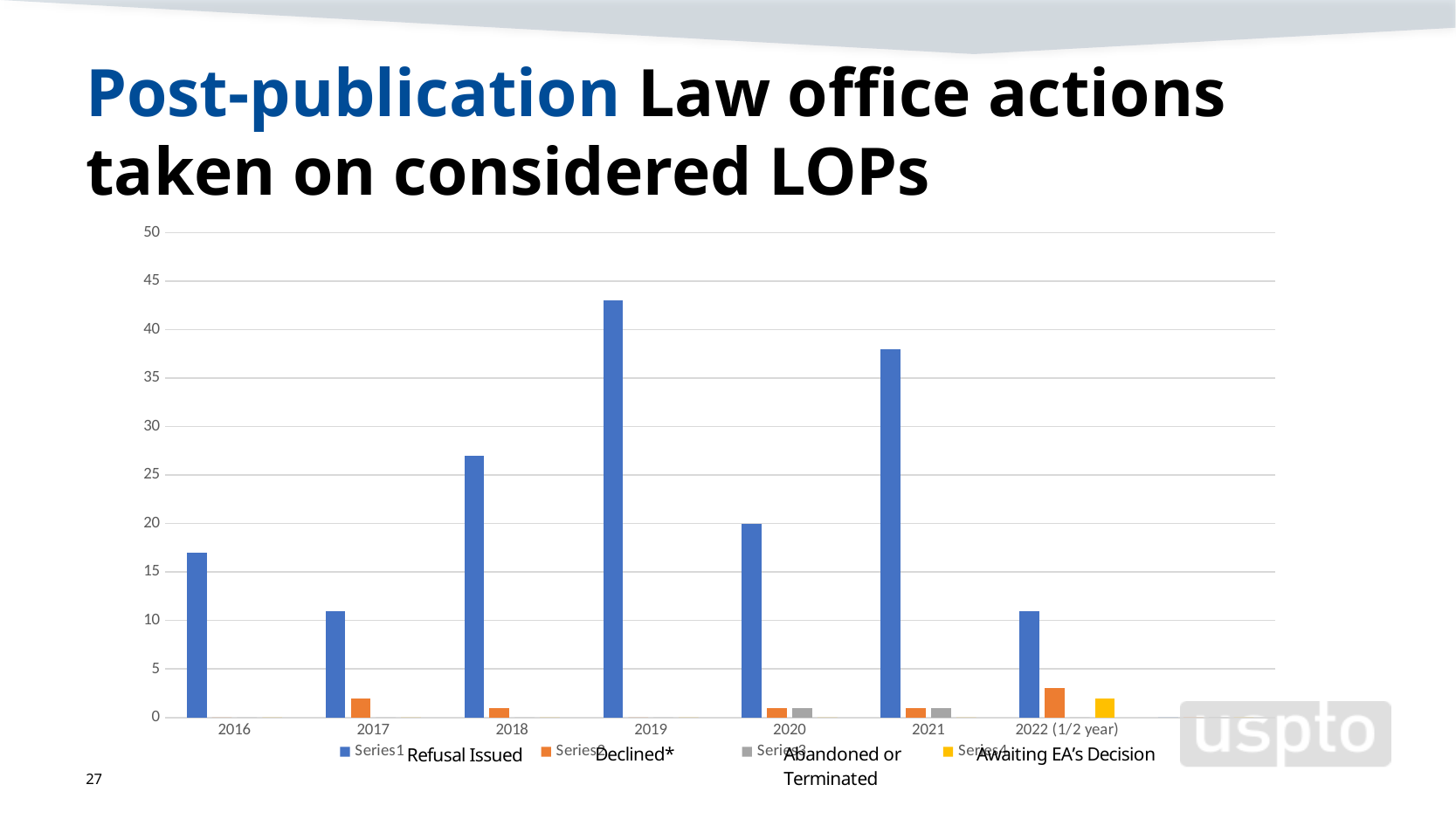
In which year is the Refusal Issued (blue) bar the highest? 2019 Which year has the larger Refusal Issued bar, 2018 or 2021? 2021 Is the Refusal Issued value for 2017 greater or less than 15? less Is the Refusal Issued value for 2019 greater or less than 40? greater Which series is shown in yellow in the legend? Awaiting EA's Decision Does the Refusal Issued value rise or fall from 2017 to 2019? rise How many series does the legend list? 4 What kind of chart is shown on the slide? bar chart How many year categories are shown on the x axis? 7 Is the Refusal Issued value for 2018 greater or less than 25? greater